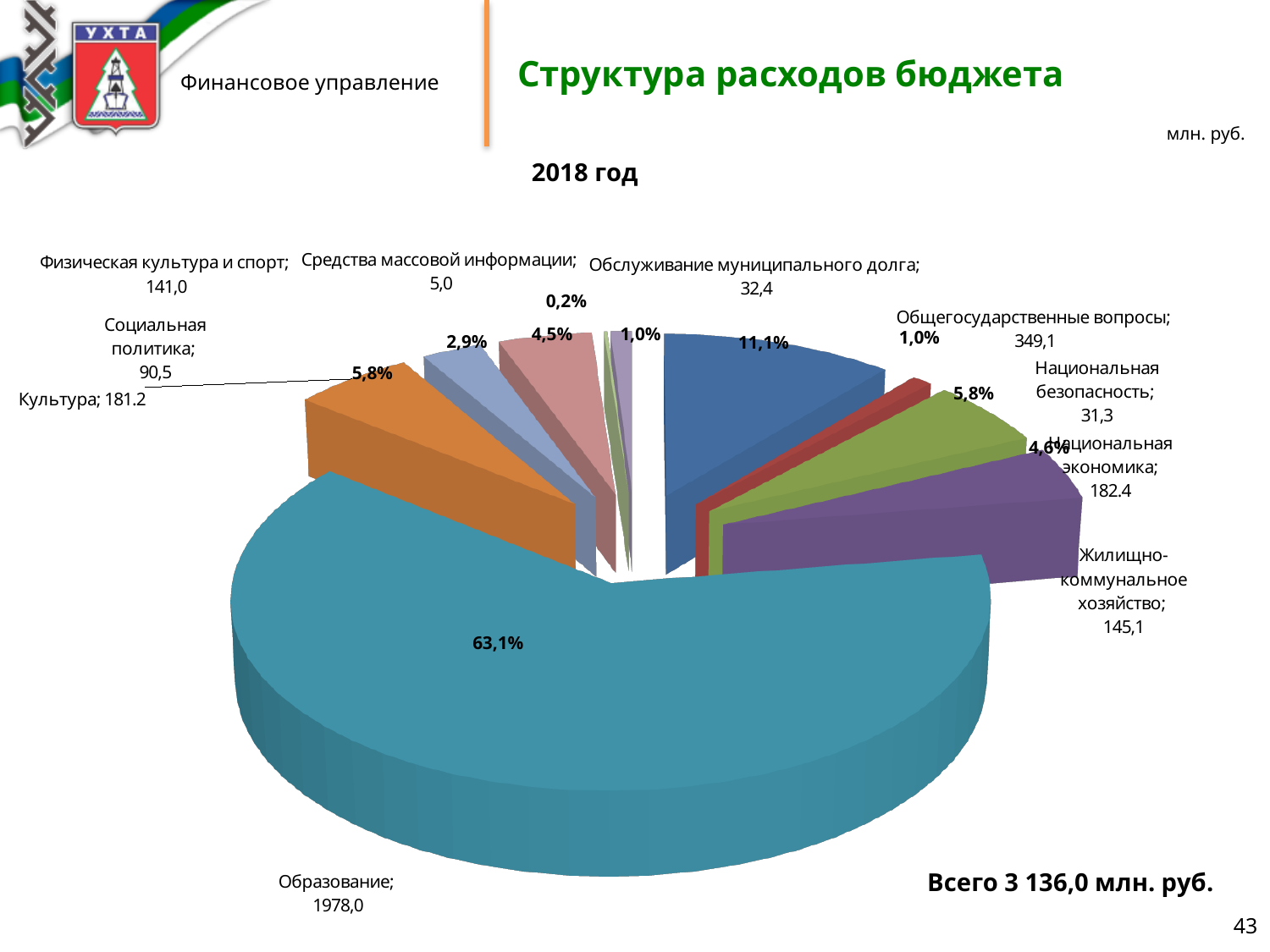
What is the difference between the values for Образование and Общегосударственные вопросы? 1628,9 Which category has the smallest value? Средства массовой информации What share of the pie does Общегосударственные вопросы represent? 11,1% What is the value for Общегосударственные вопросы? 349,1 What type of chart is shown on the slide? Pie chart What share of the pie does Образование represent? 63,1% Which category has the largest share of the pie? Образование What is the value for Средства массовой информации? 5,0 What is the value for Образование? 1978,0 How many categories does the pie chart contain? 10 What is the value for Жилищно-коммунальное хозяйство? 145,1 Which is larger: Жилищно-коммунальное хозяйство or Физическая культура и спорт? Жилищно-коммунальное хозяйство